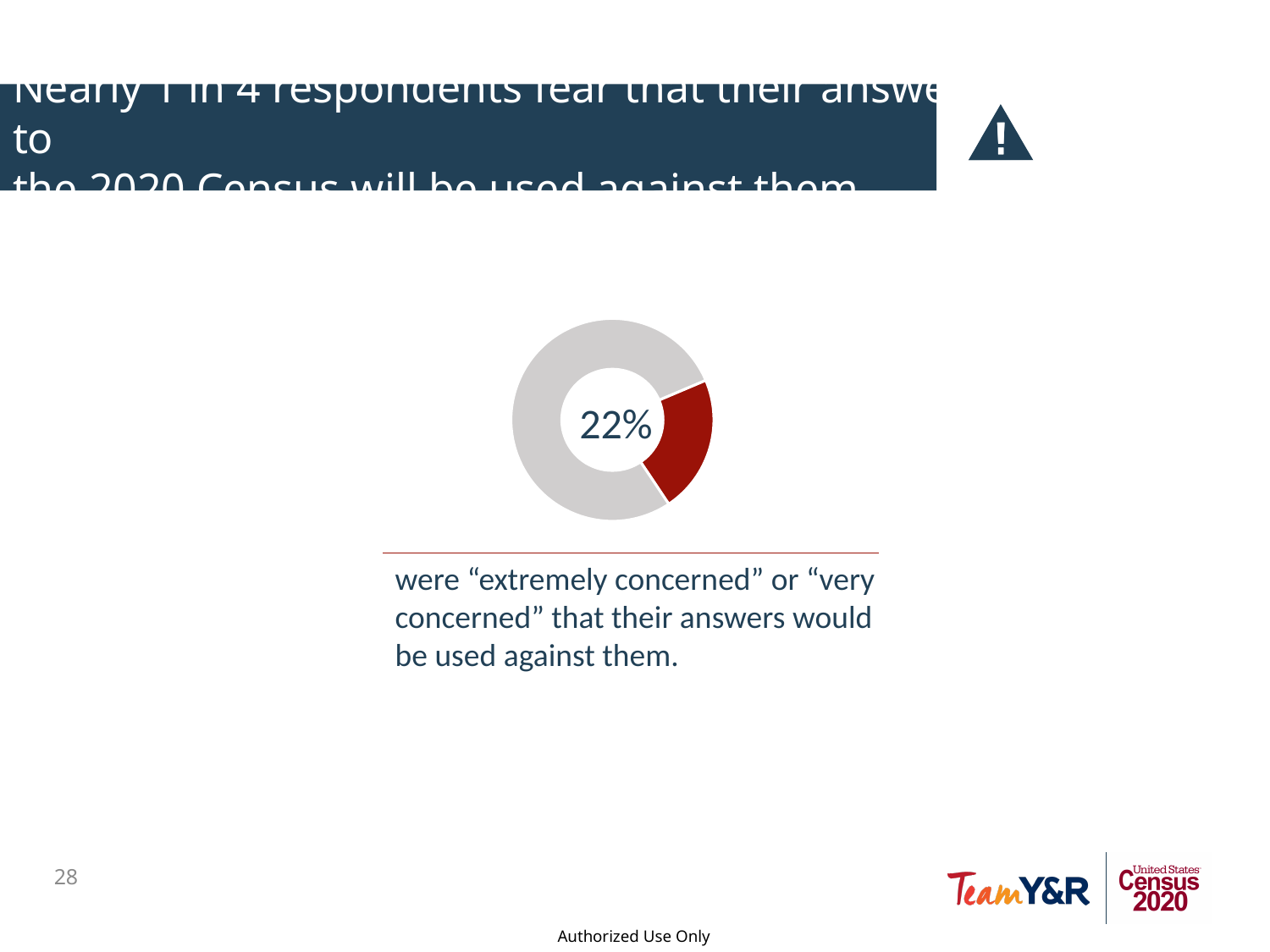
Which slice of the donut chart is larger, the red slice or the grey slice? The grey slice What share of the donut chart does the red slice represent? 22% What colour is the highlighted slice representing the 22% of respondents? Red How many slices does the donut chart have? 2 Does the red slice make up more or less than half of the donut chart? Less What percentage is printed in the centre of the donut chart? 22% What kind of chart is shown on the slide? Donut (pie) chart What percentage of respondents were "extremely concerned" or "very concerned" that their answers would be used against them? 22%